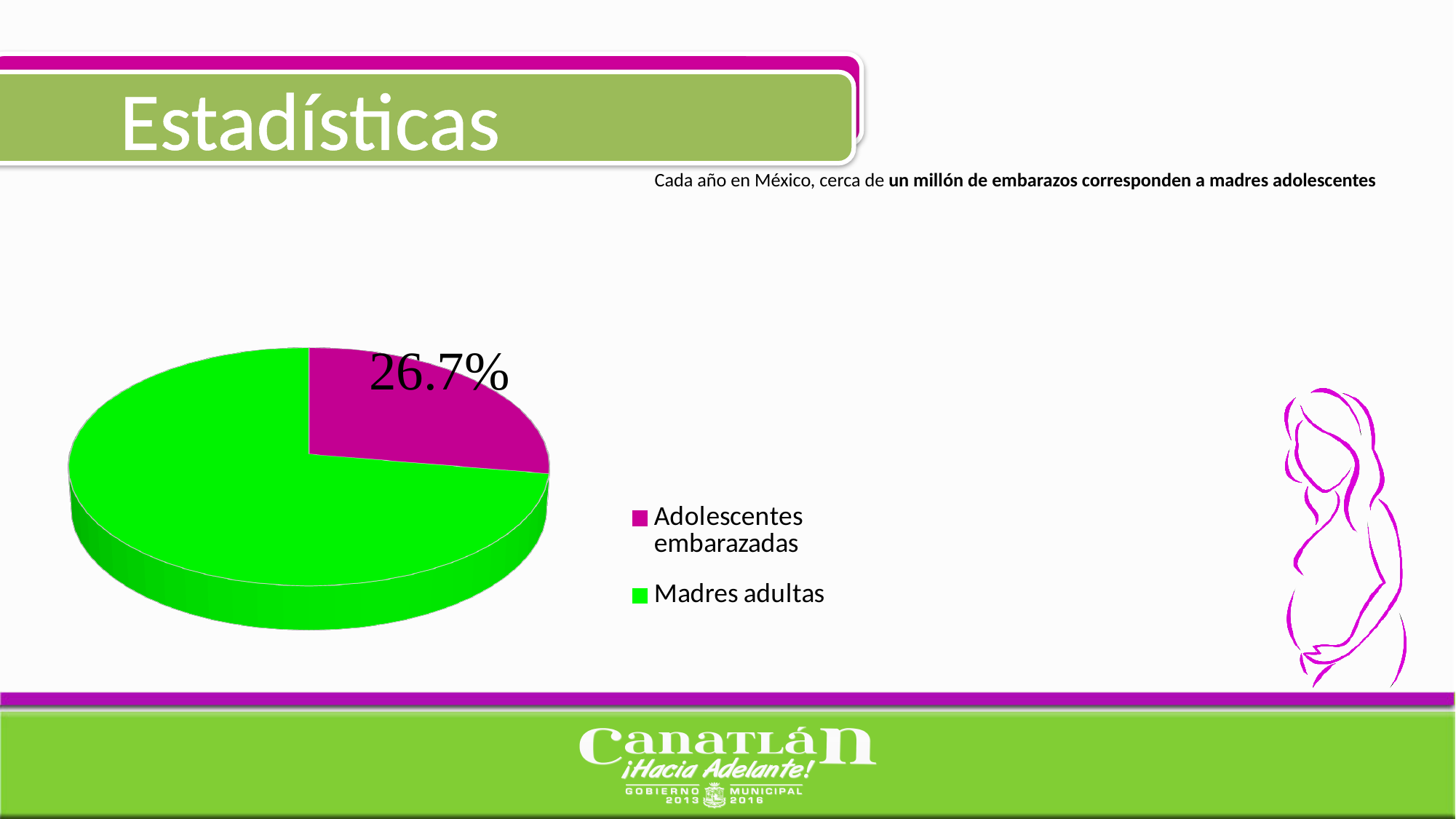
Is the share for Madres adultas greater or less than 50%? greater What colour is the Madres adultas slice? Green What colour is the Adolescentes embarazadas slice? Magenta Which category has the smallest slice of the pie? Adolescentes embarazadas What kind of chart is shown on the slide? Pie chart What percentage is shown for Adolescentes embarazadas? 26.7% What share of the pie does the Adolescentes embarazadas slice represent? 26.7% How many slices does the pie chart have? 2 How many entries does the legend list? 2 Which category has the largest slice of the pie? Madres adultas Which is larger, the slice for Madres adultas or the slice for Adolescentes embarazadas? Madres adultas